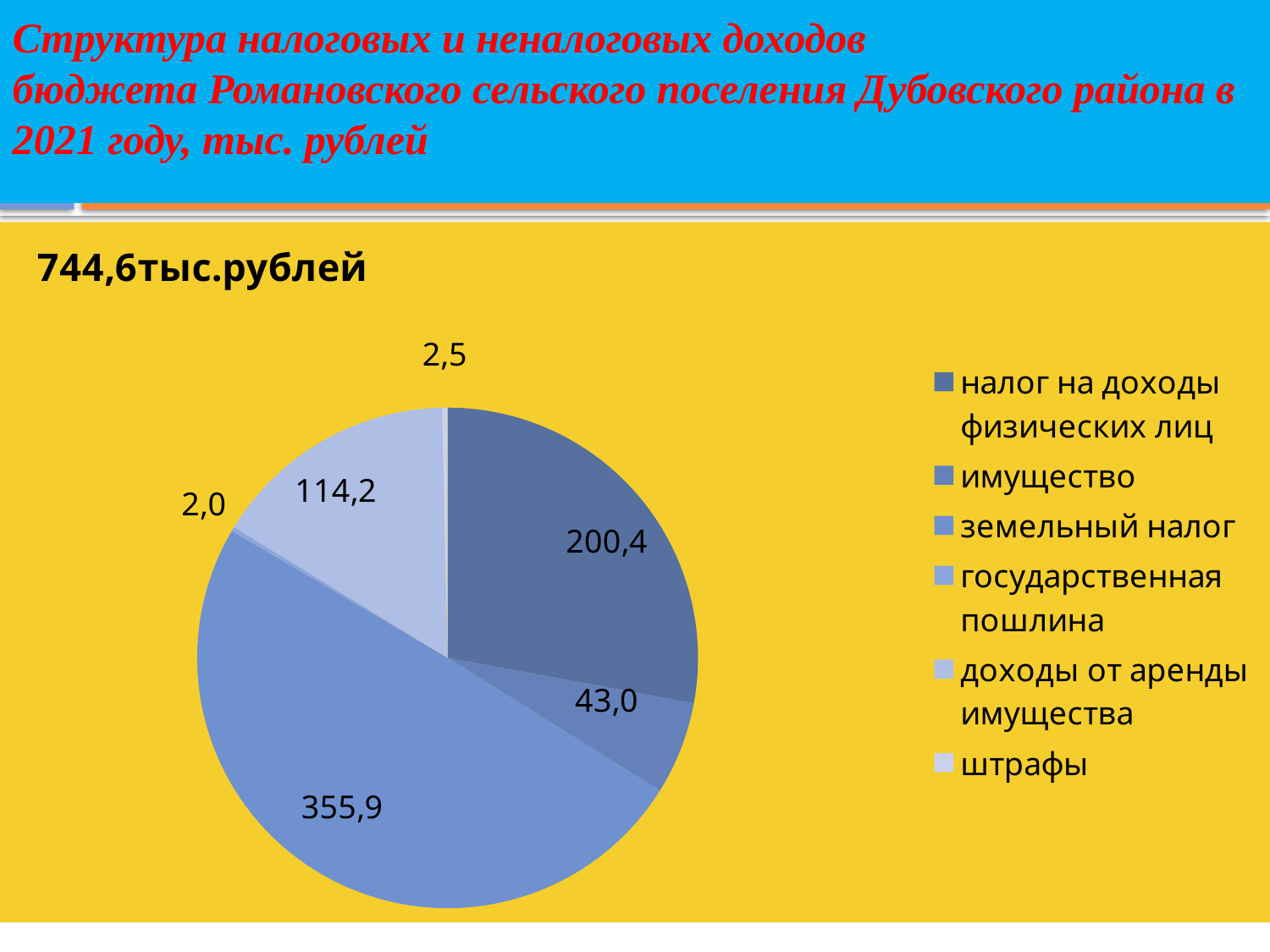
What type of chart is shown on the slide? pie chart What total amount in тыс. рублей is printed above the chart? 744,6тыс.рублей How many categories are shown in the pie chart? 6 What is the difference between the values for земельный налог and налог на доходы физических лиц? 155,5 What is the value for земельный налог? 355,9 Which category has the largest slice of the pie? земельный налог What is the value for доходы от аренды имущества? 114,2 Which category has the smallest slice of the pie? государственная пошлина What is the value for штрафы? 2,5 What is the value for налог на доходы физических лиц? 200,4 Which is larger: the value for доходы от аренды имущества or the value for имущество? доходы от аренды имущества What is the value for имущество? 43,0